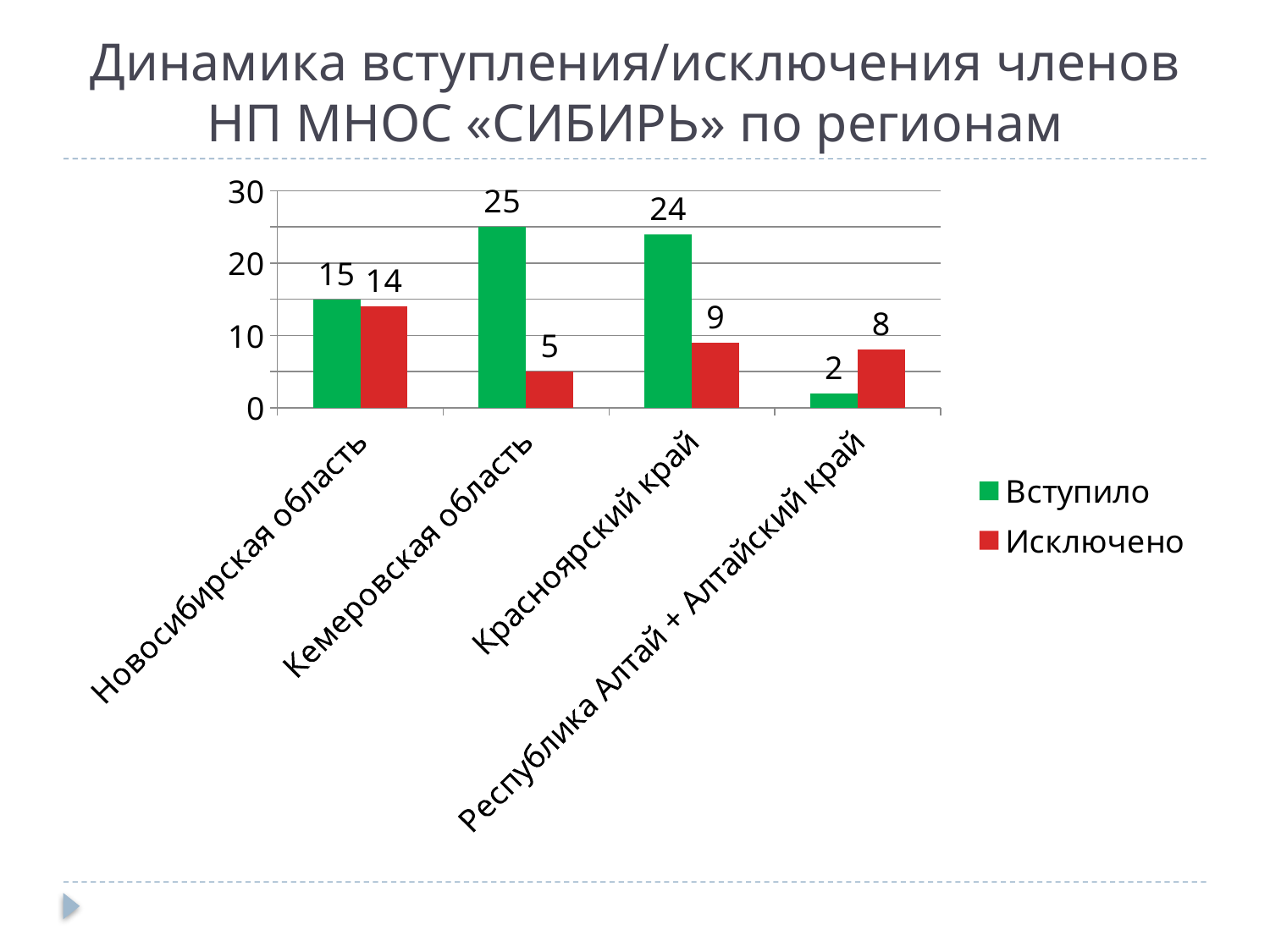
Which region has the lowest Исключено value? Кемеровская область How many series does the legend list? 2 What is the difference between Вступило and Исключено for Красноярский край? 15 What kind of chart is shown on the slide? Bar chart Which colour represents the Исключено series? Red How many regions are shown on the x axis? 4 Which region has the highest Вступило value? Кемеровская область What is the value of Вступило for Кемеровская область? 25 What is the value of Исключено for Новосибирская область? 14 Which is larger for Республика Алтай + Алтайский край: Вступило or Исключено? Исключено What is the value of Вступило for Республика Алтай + Алтайский край? 2 What is the value of Исключено for Красноярский край? 9